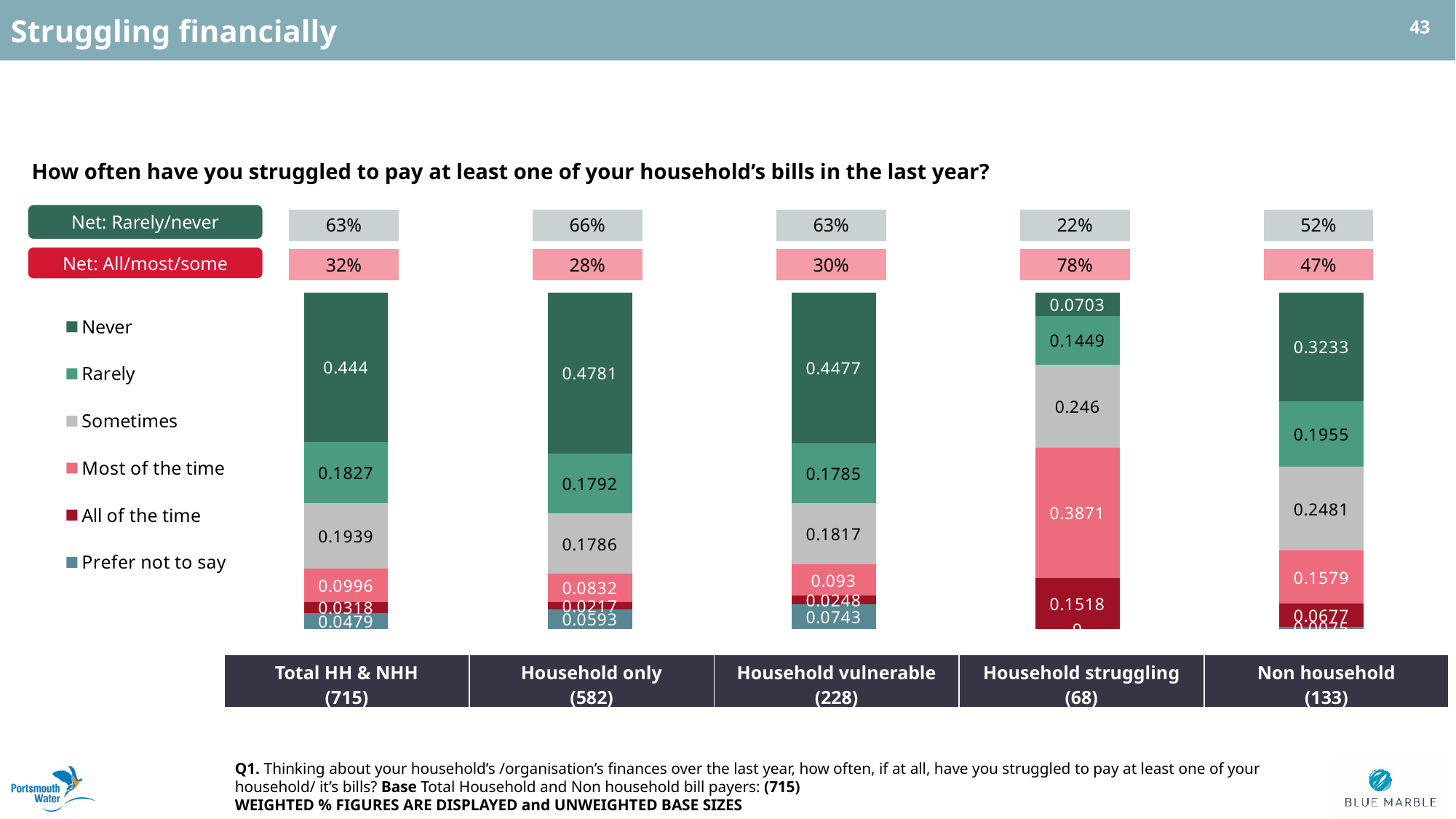
What is the Net: Rarely/never figure for the Household vulnerable group? 63% How many categories (respondent groups) are plotted along the x axis? 5 How many series does the legend list? 6 Which group has the lowest value for 'Never'? Household struggling What is the value for 'Sometimes' in the Non household group? 0.2481 Which group has the highest Net: All/most/some figure? Household struggling What is the value for 'Never' in the Household only group? 0.4781 What is the value for 'Most of the time' in the Household struggling group? 0.3871 What is the difference between the Net: Rarely/never and Net: All/most/some figures for the Household only group? 38 percentage points What kind of chart is shown on the slide? Stacked bar chart Which is larger: the 'Rarely' value for Total HH & NHH or for Non household? Non household What is the unweighted base size shown for the Household vulnerable group? 228